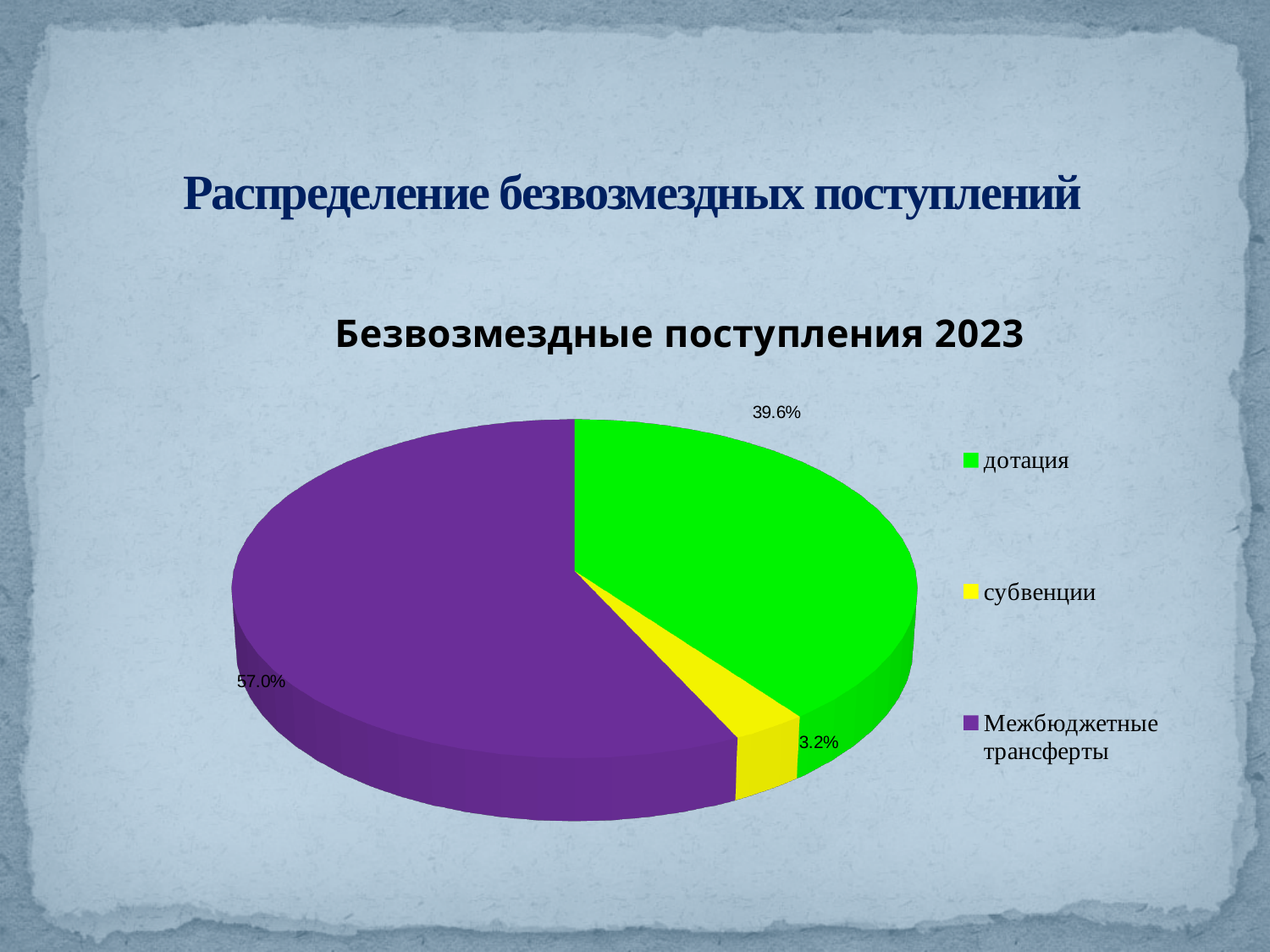
Which is larger, the share for дотация or the share for субвенции? дотация What colour is the slice for субвенции? yellow What kind of chart is shown on the slide? pie chart What share of the pie does дотация have? 39.6% How many categories does the pie chart show? 3 What share of the pie does субвенции have? 3.2% What share of the pie does Межбюджетные трансферты have? 57.0% What is the difference in percentage points between Межбюджетные трансферты and дотация? 17.4 What is the difference in percentage points between дотация and субвенции? 36.4 Which category has the smallest slice of the pie? субвенции Which category has the largest slice of the pie? Межбюджетные трансферты What is the chart's title? Безвозмездные поступления 2023